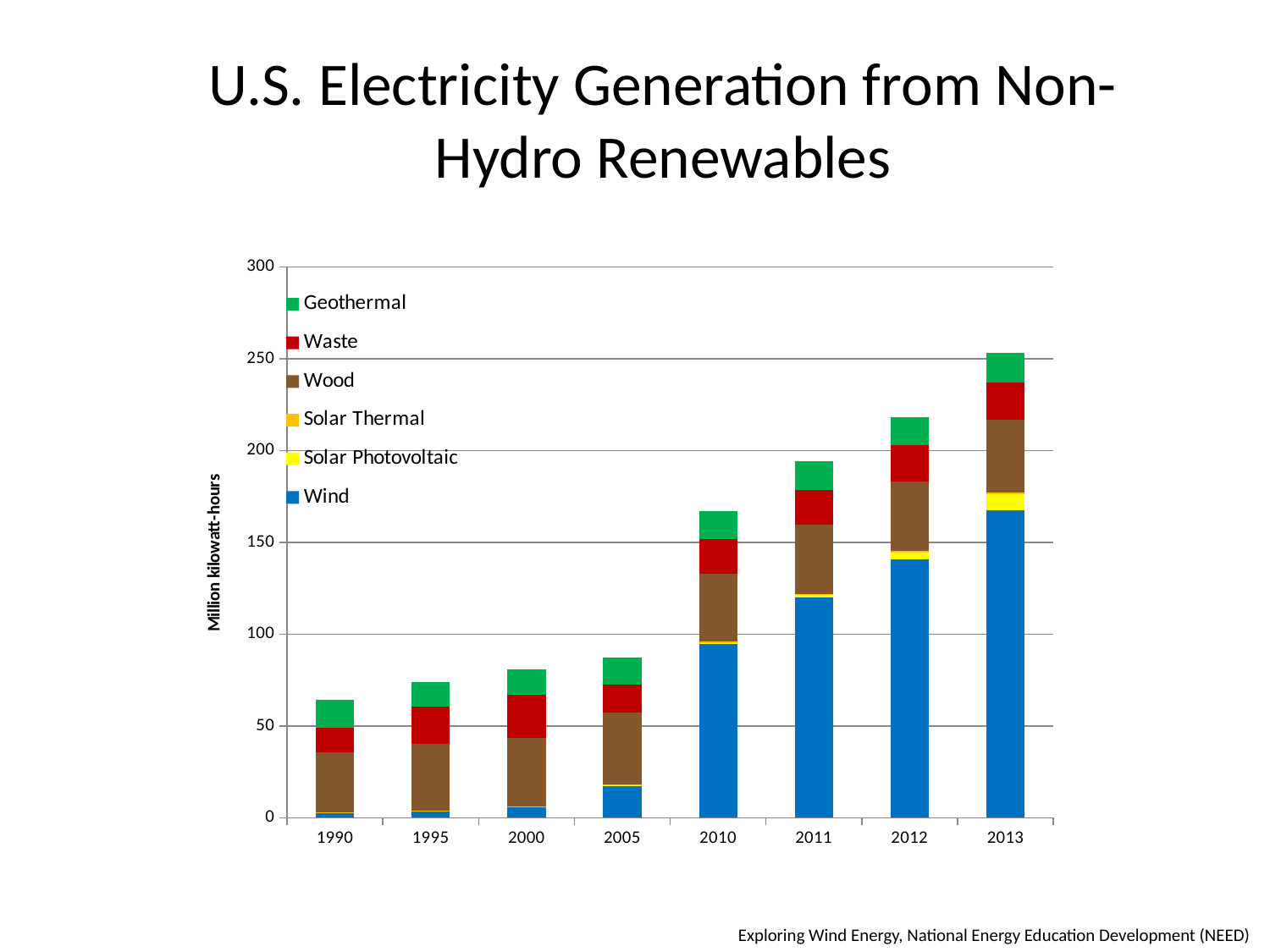
Do the total values generally rise or fall from 1990 to 2013? rise How many years are shown along the x axis of the chart? 8 What is the label on the vertical axis of the chart? Million kilowatt-hours Is the Wind value for 2005 greater or less than 50 million kilowatt-hours? less Which year has the larger total, 2005 or 2011? 2011 How many series does the chart's legend list? 6 Is the total for 2000 greater or less than 100 million kilowatt-hours? less What kind of chart is shown on the slide? Stacked bar chart Is the Wind value for 2013 greater or less than 150 million kilowatt-hours? greater Which year has the highest total electricity generation from non-hydro renewables? 2013 Which year has the lowest total electricity generation from non-hydro renewables? 1990